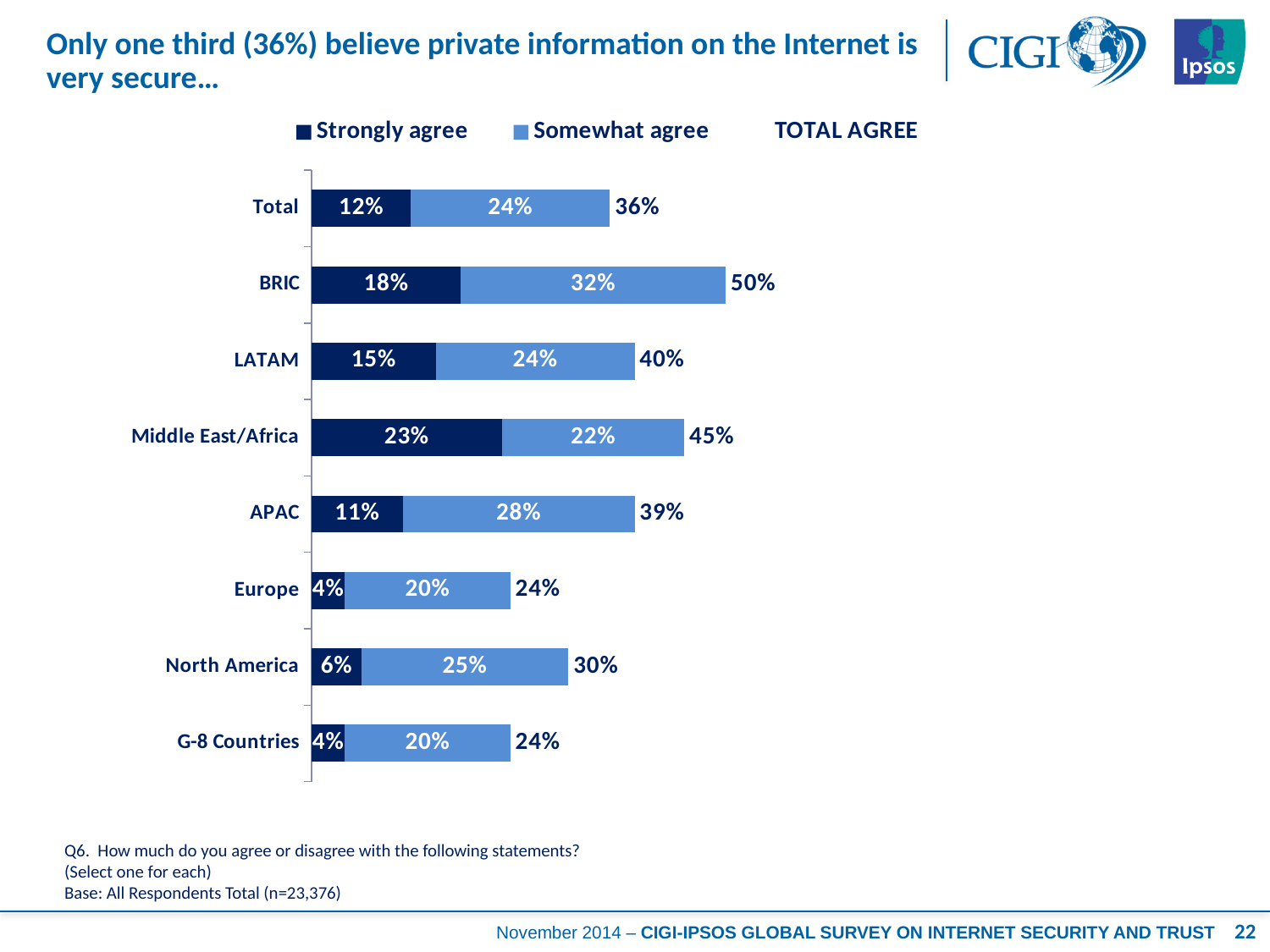
What is the 'Somewhat agree' value for APAC? 28% What is the 'Strongly agree' value for BRIC? 18% What is the difference between the TOTAL AGREE values for BRIC and Total? 14% How many series does the legend list? 3 Which region has the highest TOTAL AGREE value? BRIC What is the total of the stacked bar for North America? 30% What kind of chart is shown on the slide? Stacked bar chart Which region has the lowest 'Strongly agree' value, Europe or North America? Europe Which region has the highest 'Strongly agree' value? Middle East/Africa How many categories are shown on the chart? 8 Is the TOTAL AGREE value for LATAM larger than that for APAC? Yes What is the TOTAL AGREE value for Middle East/Africa? 45%